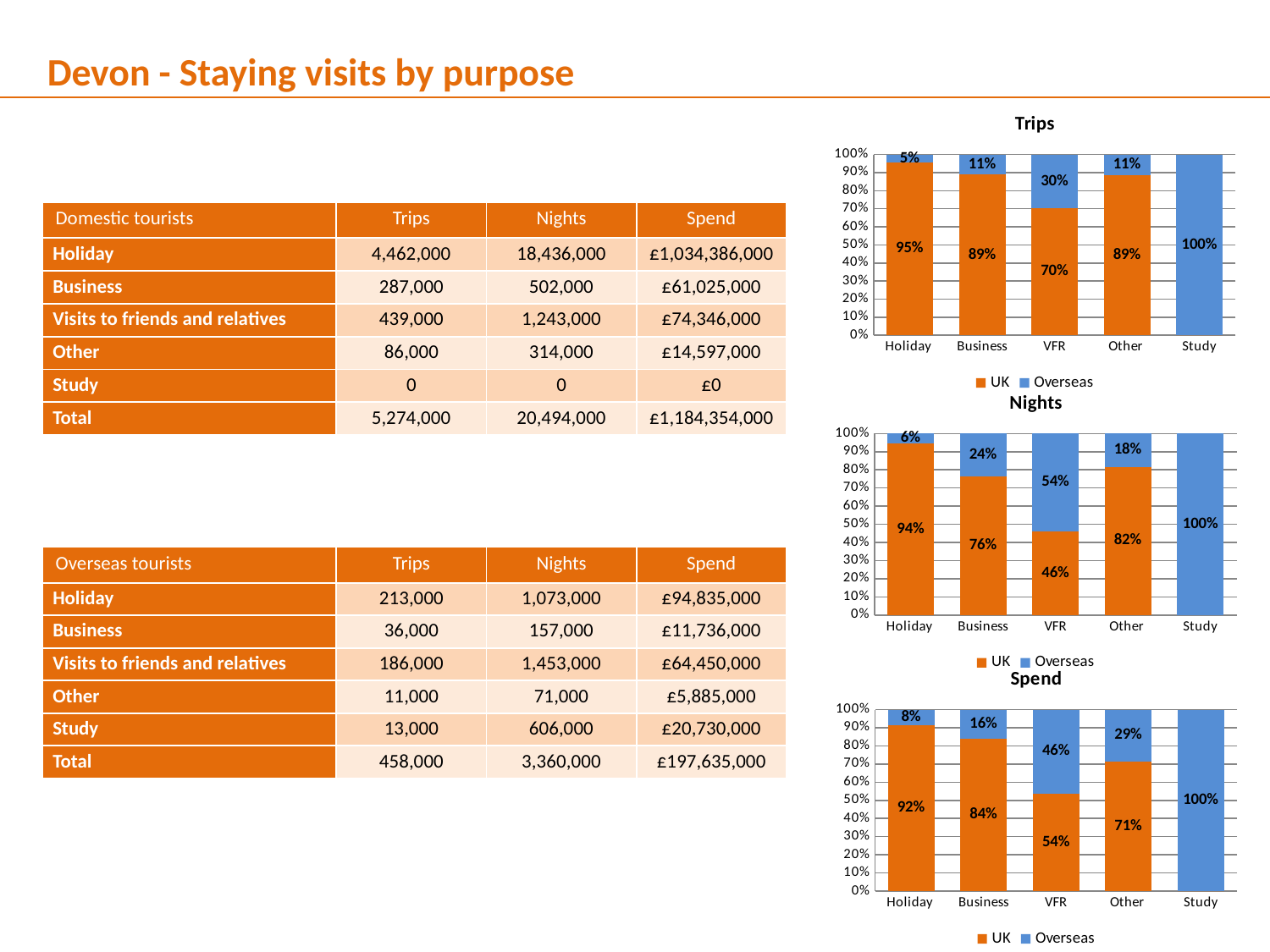
In the Trips chart, what is the UK share for VFR? 70% What type of chart is the Trips chart? Stacked bar chart In the Trips chart, what is the Overseas share for Business? 11% In the Spend chart, what is the UK share for Business? 84% In the Trips chart, is the Overseas share larger for VFR or for Other? VFR In the Spend chart, which category has the lowest UK share? Study In the Nights chart, what is the UK share for Other? 82% In the Nights chart, which category has the highest UK share? Holiday How many series does the legend of the Spend chart list? 2 How many categories are shown on the x axis of the Nights chart? 5 In the Spend chart, what is the difference between the UK share for Holiday and the UK share for VFR? 38% In the Nights chart, what is the Overseas share for VFR? 54%